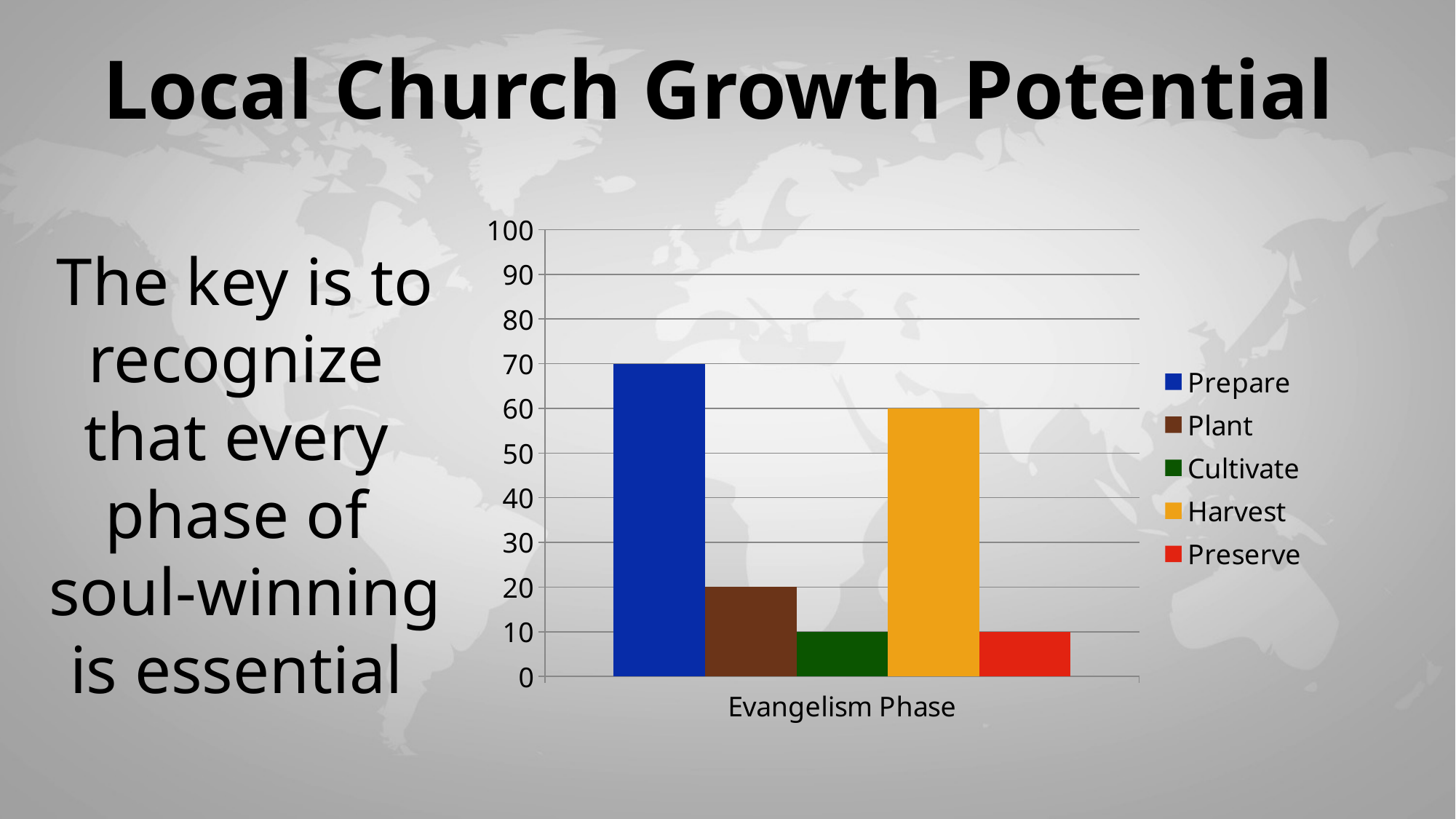
Is the value for Prepare greater or less than 50? greater How many series does the legend list? 5 What kind of chart is shown on the slide? bar chart What is the label on the x axis of the chart? Evangelism Phase Which is larger, the Harvest value or the Plant value? Harvest What is the value of the Cultivate bar? 10 What is the difference between the Harvest and Plant values? 40 Which series has the highest bar? Prepare What is the value of the Prepare bar? 70 What is the value of the Harvest bar? 60 What is the difference between the Prepare and Harvest values? 10 What is the value of the Plant bar? 20